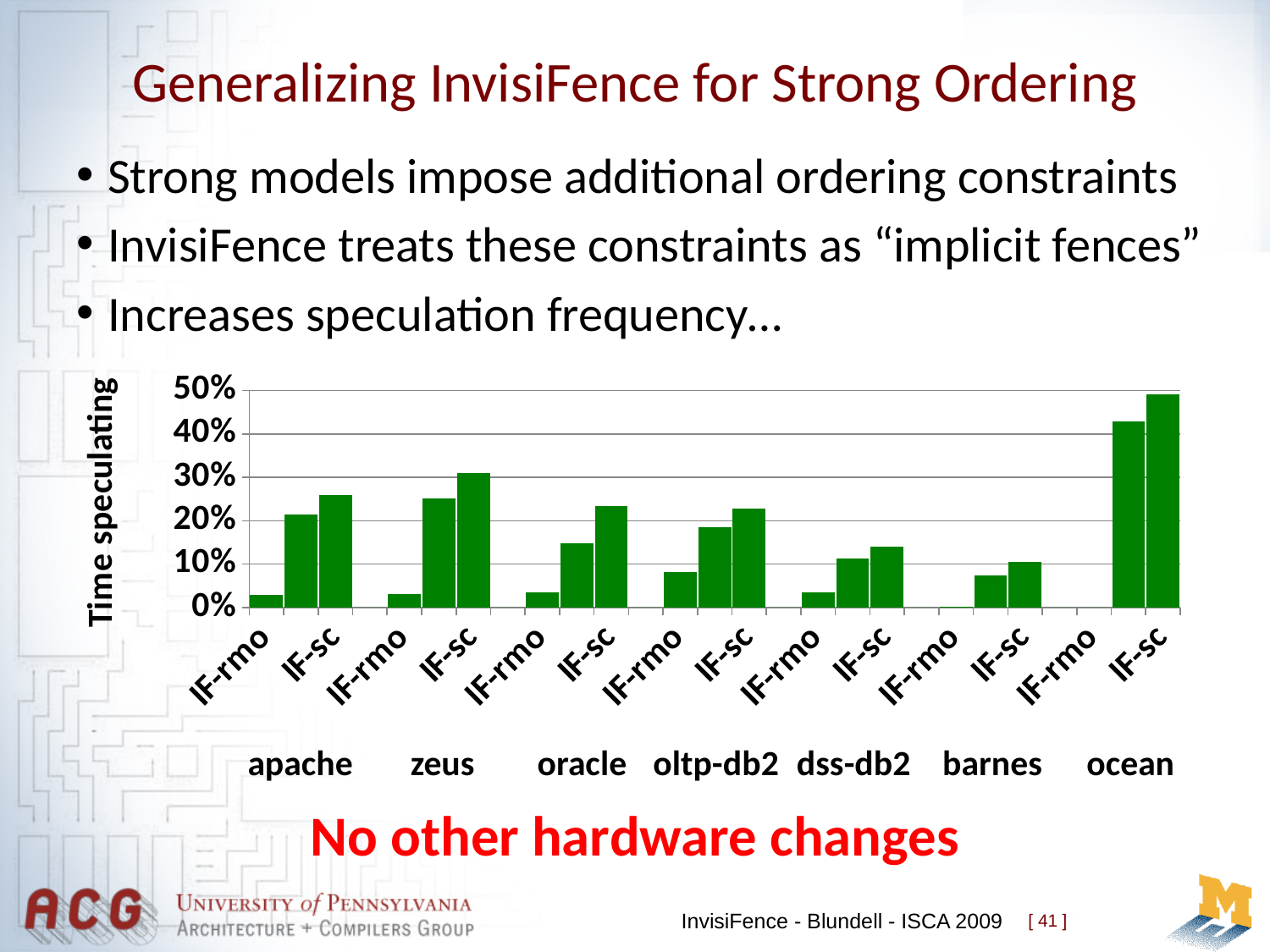
Which benchmark has the lowest IF-sc bar? barnes How many benchmark groups are shown along the x axis of the chart? 7 Is the IF-sc value for ocean greater or less than 40%? greater Which benchmark has the highest IF-sc bar? ocean Which is larger: the IF-sc value for ocean or the IF-sc value for apache? ocean Is the IF-sc value for apache greater or less than 20%? greater Is the IF-rmo value for apache greater or less than 10%? less What kind of chart is shown on the slide? bar chart Which is larger: the IF-sc value for zeus or the IF-sc value for dss-db2? zeus What is the label of the vertical axis of the chart? Time speculating What is the highest tick value shown on the vertical axis of the chart? 50%